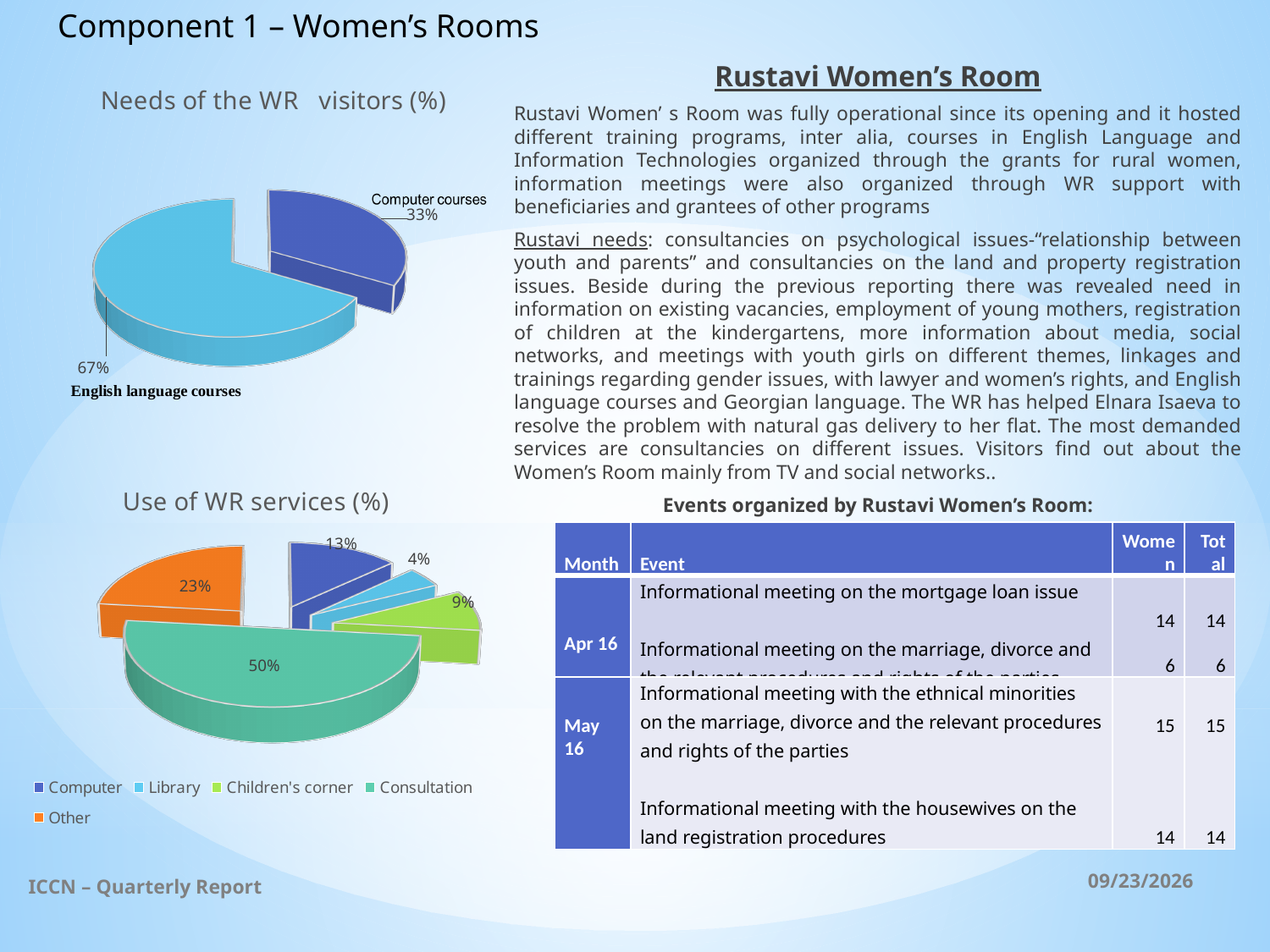
In the 'Needs of the WR visitors (%)' chart, what share is shown for Computer courses? 33% In the 'Use of WR services (%)' chart, what share is shown for Library? 4% How many categories are shown in the 'Needs of the WR visitors (%)' chart? 2 How many categories does the legend of the 'Use of WR services (%)' chart list? 5 In the 'Use of WR services (%)' chart, what share is shown for Other? 23% In the 'Use of WR services (%)' chart, what share is shown for Consultation? 50% In the 'Needs of the WR visitors (%)' chart, which category has the larger share? English language courses In the 'Use of WR services (%)' chart, which service has the smallest share? Library In the 'Use of WR services (%)' chart, which is larger: Computer or Children's corner? Computer In the 'Needs of the WR visitors (%)' chart, what share is shown for English language courses? 67% What type of chart is the 'Needs of the WR visitors (%)' chart? Pie chart In the 'Needs of the WR visitors (%)' chart, what is the difference between the English language courses share and the Computer courses share? 34%